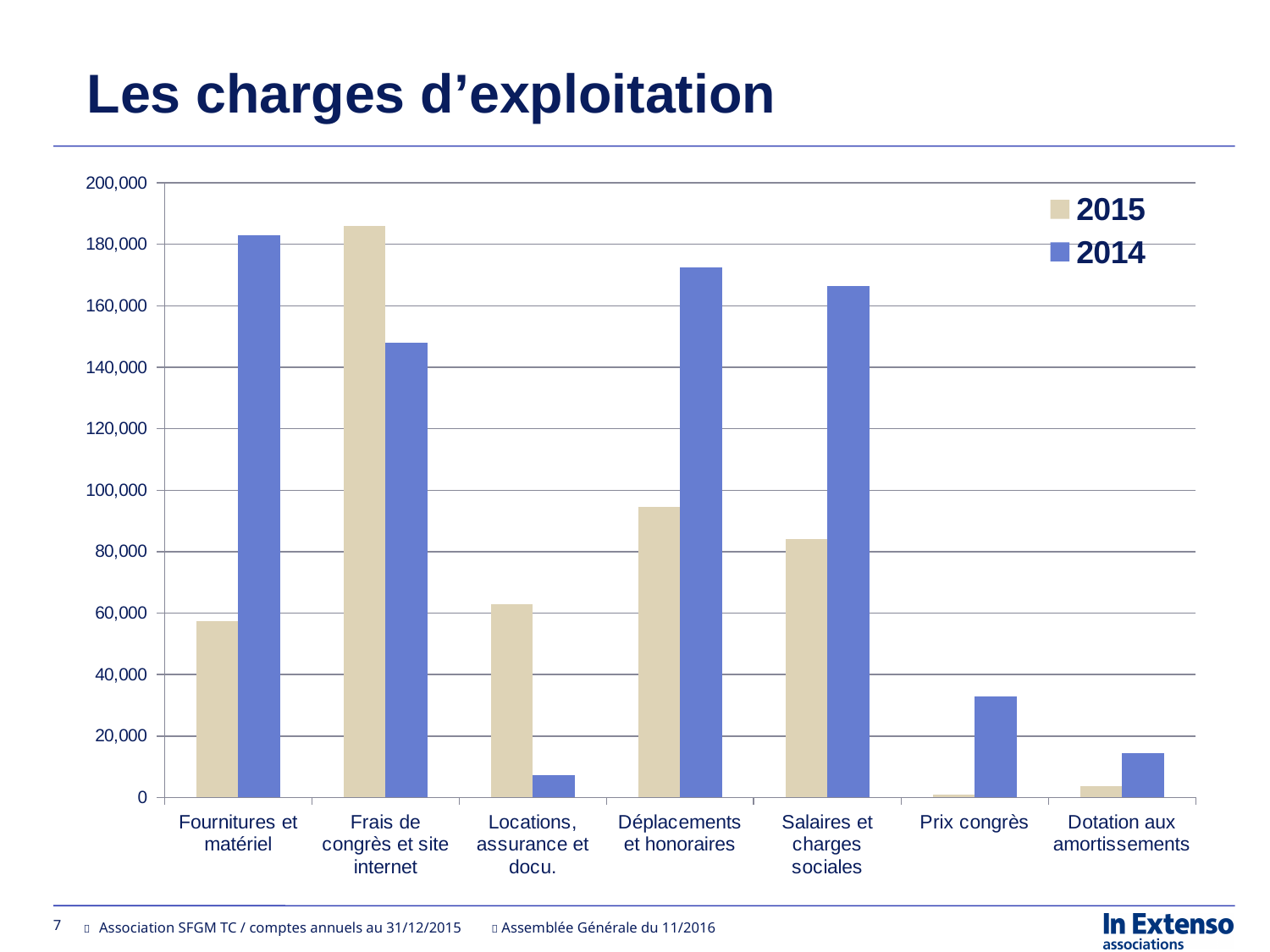
What is the title of the chart? Les charges d'exploitation Is the 2015 value for Salaires et charges sociales greater or less than 100,000? less For Frais de congrès et site internet, which year has the larger value, 2015 or 2014? 2015 For Fournitures et matériel, which year has the larger value, 2015 or 2014? 2014 Which category has the highest value for 2014? Fournitures et matériel What type of chart is shown on the slide? bar chart How many categories are shown on the x axis? 7 How many series does the legend list? 2 Is the 2014 value for Déplacements et honoraires greater or less than 160,000? greater Which category has the lowest value for 2015? Prix congrès Which category has the lowest value for 2014? Locations, assurance et docu. Which category has the highest value for 2015? Frais de congrès et site internet